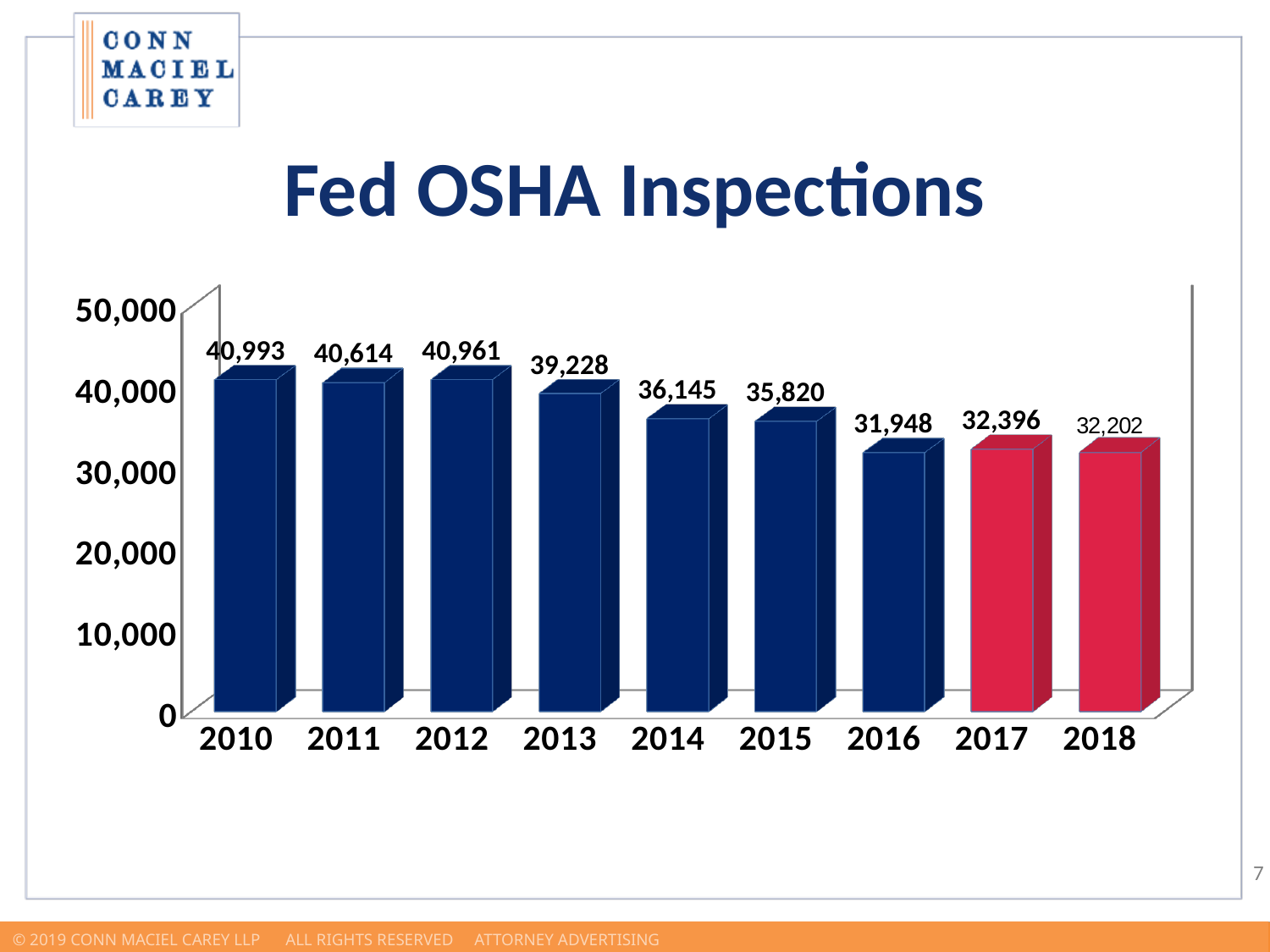
Is the value for 2014 greater or less than 40,000? less What is the number of Fed OSHA inspections shown for 2010? 40,993 What colour are the bars for 2017 and 2018? red How many years are shown on the x axis of the chart? 9 Which year has the larger value, 2011 or 2012? 2012 What kind of chart is shown on the slide? bar chart Which year has the highest number of Fed OSHA inspections? 2010 What is the difference between the 2010 and 2018 values? 8,791 Which year has the lowest number of Fed OSHA inspections? 2016 By how much did inspections increase from 2016 to 2017? 448 What value is shown for 2018? 32,202 What value is shown for 2016 in the Fed OSHA Inspections chart? 31,948